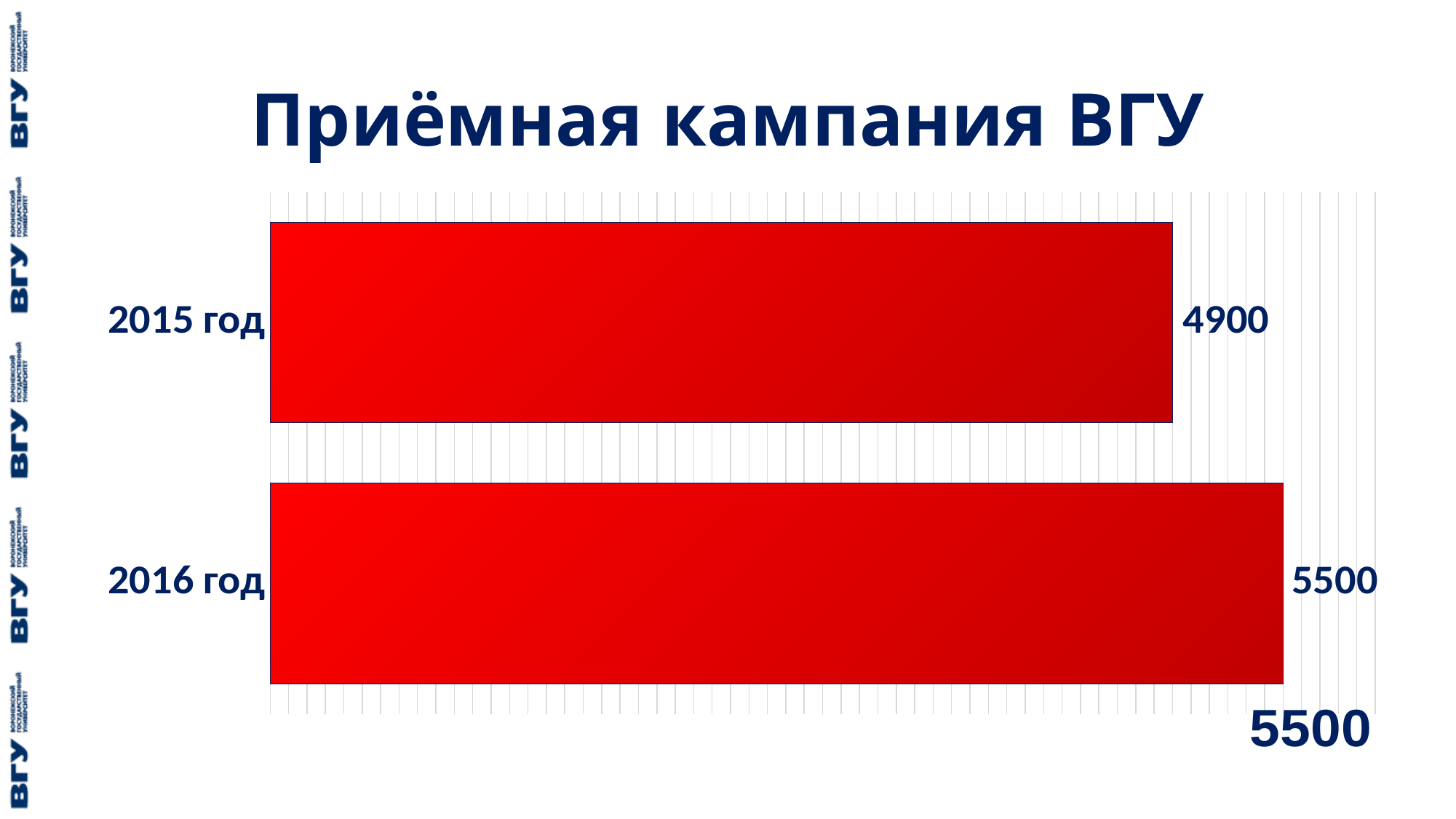
Do the values rise or fall from 2015 год to 2016 год? rise How many categories are shown in the chart? 2 Which is larger, the value for 2015 год or for 2016 год? 2016 год What colour are the bars in the chart? red Which year has the lowest value? 2015 год What is the title of the slide? Приёмная кампания ВГУ Which year has the highest value? 2016 год What is the value for 2016 год? 5500 What is the difference between the values for 2016 год and 2015 год? 600 What kind of chart is shown on the slide? bar chart What is the value for 2015 год? 4900